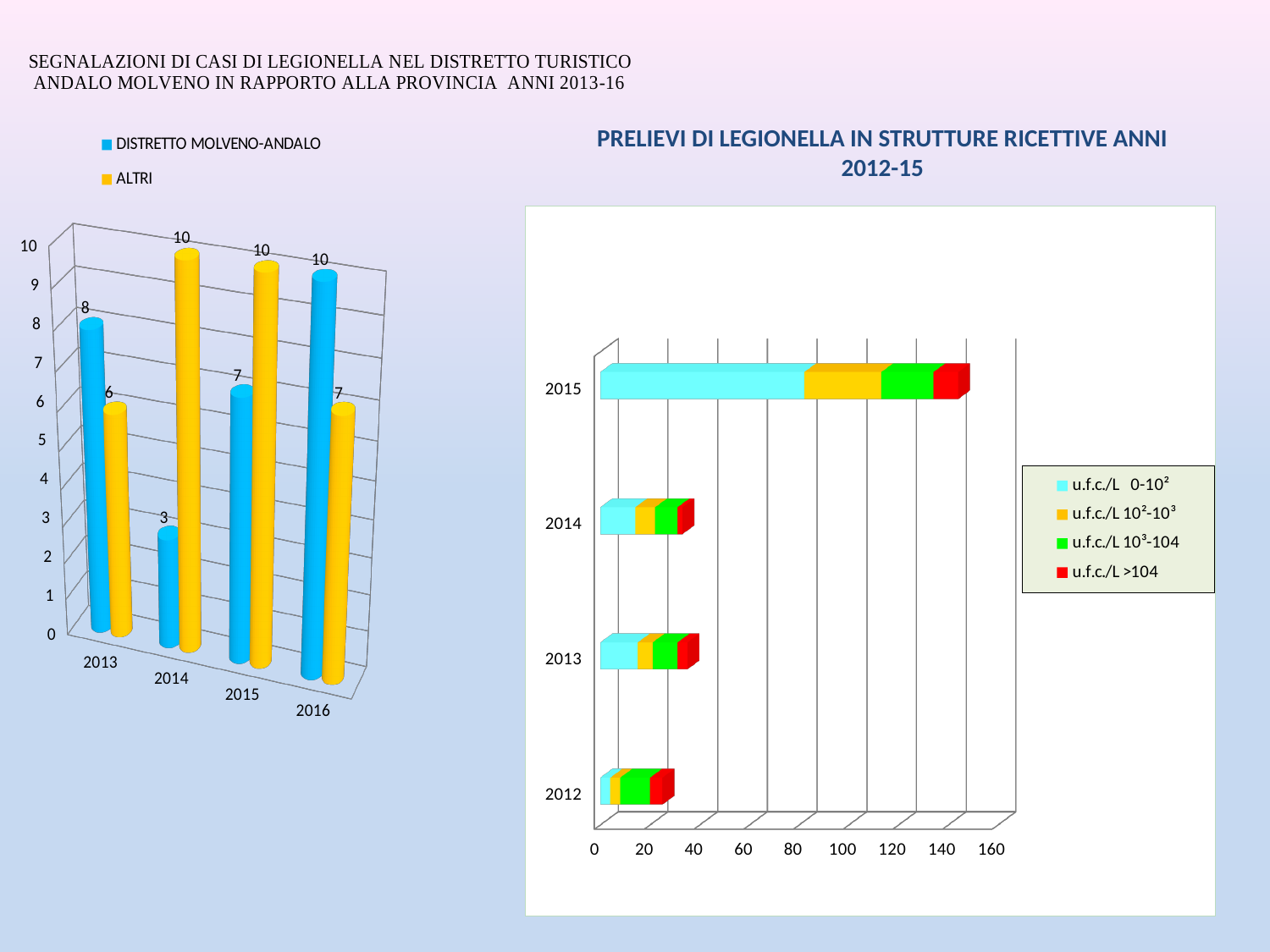
In the left chart (Segnalazioni di casi di legionella), what is the value for DISTRETTO MOLVENO-ANDALO in 2016? 10 What kind of chart is the right chart (Prelievi di legionella in strutture ricettive anni 2012-15)? Stacked bar chart In the left chart (Segnalazioni di casi di legionella), how many series does the legend list? 2 In the left chart (Segnalazioni di casi di legionella), what is the value for DISTRETTO MOLVENO-ANDALO in 2013? 8 In the right chart (Prelievi di legionella in strutture ricettive anni 2012-15), is the total value for 2015 greater or less than 120? greater In the left chart (Segnalazioni di casi di legionella), which year has the lowest value for DISTRETTO MOLVENO-ANDALO? 2014 In the right chart (Prelievi di legionella in strutture ricettive anni 2012-15), which year has the highest total? 2015 In the right chart (Prelievi di legionella in strutture ricettive anni 2012-15), how many series does the legend list? 4 In the left chart (Segnalazioni di casi di legionella), what is the value for ALTRI in 2014? 10 In the left chart (Segnalazioni di casi di legionella), what is the difference between ALTRI and DISTRETTO MOLVENO-ANDALO in 2014? 7 In the left chart (Segnalazioni di casi di legionella), which is larger in 2016, DISTRETTO MOLVENO-ANDALO or ALTRI? DISTRETTO MOLVENO-ANDALO In the left chart (Segnalazioni di casi di legionella), how many years are shown on the x axis? 4